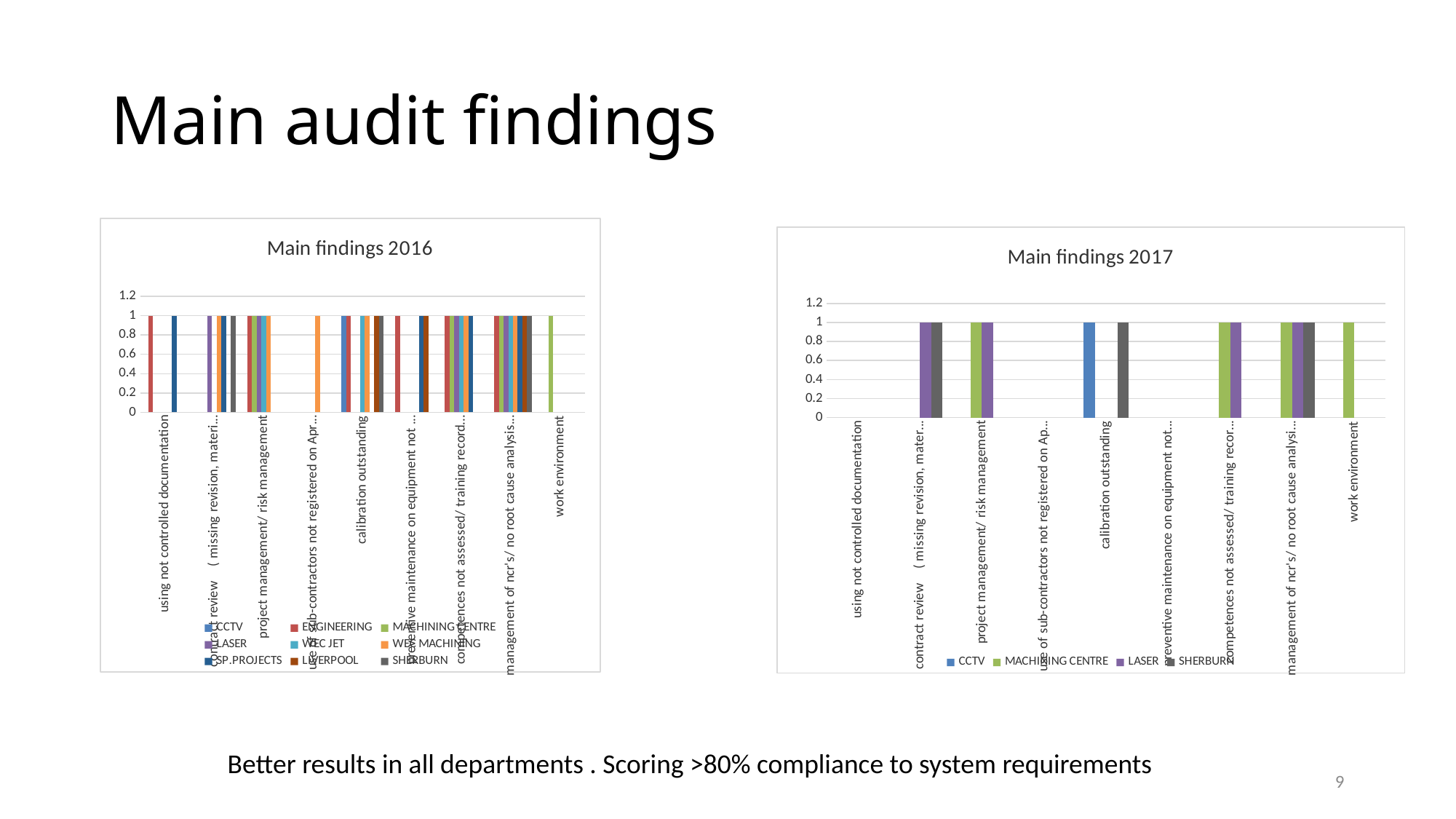
What is the title of the chart on the right of the slide? Main findings 2017 In the 'Main findings 2016' chart, is the value of the MACHINING CENTRE bar for 'work environment' greater or less than 0.8? greater In the 'Main findings 2017' chart, how many bars are plotted for 'calibration outstanding'? 2 Which series is listed first in the legend of the 'Main findings 2017' chart? CCTV In the 'Main findings 2017' chart, what is the value of the CCTV bar for 'calibration outstanding'? 1 In the 'Main findings 2017' chart, is the SHERBURN bar for 'calibration outstanding' greater or less than 0.6? greater In the 'Main findings 2017' chart, how many bars are plotted for 'using not controlled documentation'? 0 How many categories are shown on the x axis of the 'Main findings 2017' chart? 9 In the 'Main findings 2017' chart, what is the value of the MACHINING CENTRE bar for 'work environment'? 1 How many series does the legend of the 'Main findings 2017' chart list? 4 What kind of chart is the 'Main findings 2016' chart? bar chart How many series does the legend of the 'Main findings 2016' chart list? 9